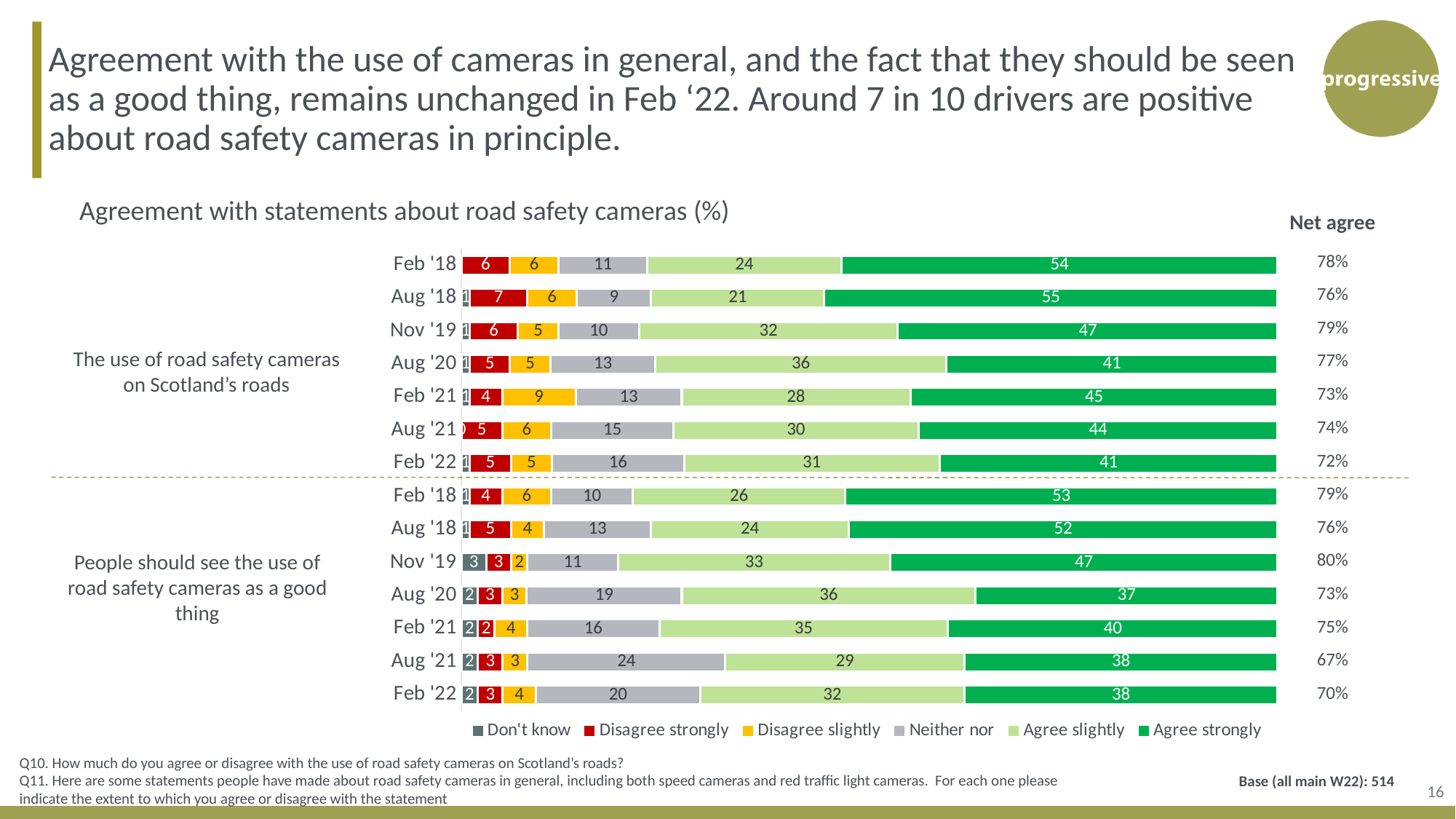
What kind of chart is shown on the slide? Stacked bar chart For Feb '22 for the statement 'The use of road safety cameras on Scotland's roads', what is the combined total of 'Agree slightly' and 'Agree strongly'? 72 Across both statements, which wave has the lowest Net agree figure? Aug '21 (People should see the use of road safety cameras as a good thing) How many series does the legend list? 6 What colour represents 'Disagree strongly' in the chart? Red What is the Net agree figure for Nov '19 for the statement 'People should see the use of road safety cameras as a good thing'? 80% What is the 'Neither nor' value for Aug '21 for the statement 'People should see the use of road safety cameras as a good thing'? 24 How many bars (survey waves) are plotted in total across both statements? 14 For the statement 'People should see the use of road safety cameras as a good thing', is the 'Agree slightly' value higher in Aug '20 or Aug '21? Aug '20 What is the 'Agree strongly' value for Feb '22 for the statement 'The use of road safety cameras on Scotland's roads'? 41 For the statement 'The use of road safety cameras on Scotland's roads', which wave has the highest 'Agree strongly' value? Aug '18 What is the difference between the 'Agree strongly' values for Feb '18 and Feb '22 for the statement 'The use of road safety cameras on Scotland's roads'? 13